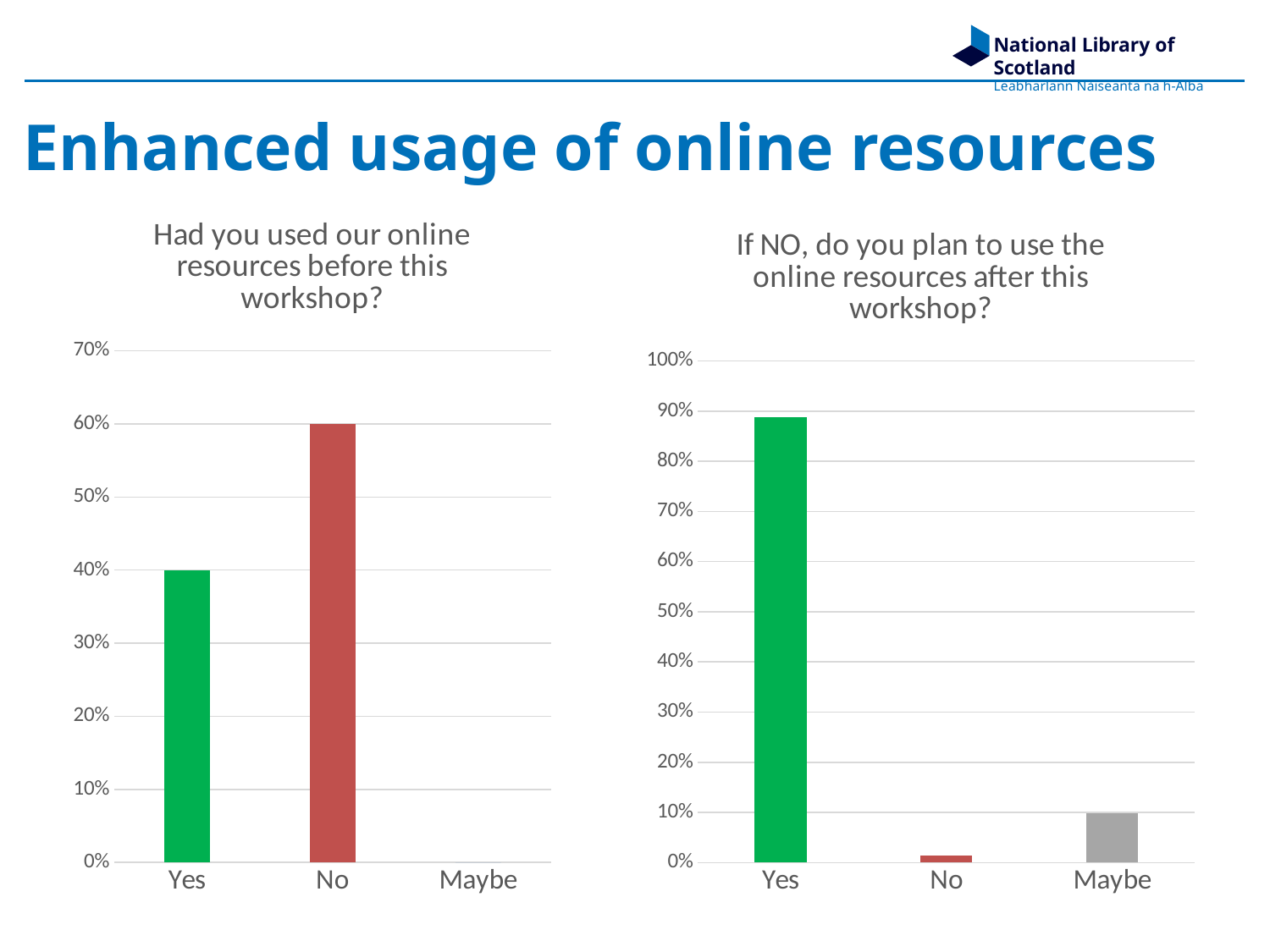
In the chart titled "Had you used our online resources before this workshop?", what is the difference between the values for No and Yes? 20% What kind of chart is the chart on the right of the slide? bar chart In the chart titled "If NO, do you plan to use the online resources after this workshop?", which category has the lowest value? No In the chart titled "If NO, do you plan to use the online resources after this workshop?", is the value for Maybe larger or smaller than the value for No? larger In the chart titled "Had you used our online resources before this workshop?", which category has the highest value? No In the chart titled "Had you used our online resources before this workshop?", how many categories are shown on the x axis? 3 What colour is the Yes bar in the chart on the left of the slide? green In the chart titled "If NO, do you plan to use the online resources after this workshop?", is the value for Yes greater or less than 80%? greater In the chart titled "If NO, do you plan to use the online resources after this workshop?", which category has the highest value? Yes In the chart titled "Had you used our online resources before this workshop?", what is the value for Yes? 40% In the chart titled "Had you used our online resources before this workshop?", what is the value for No? 60%